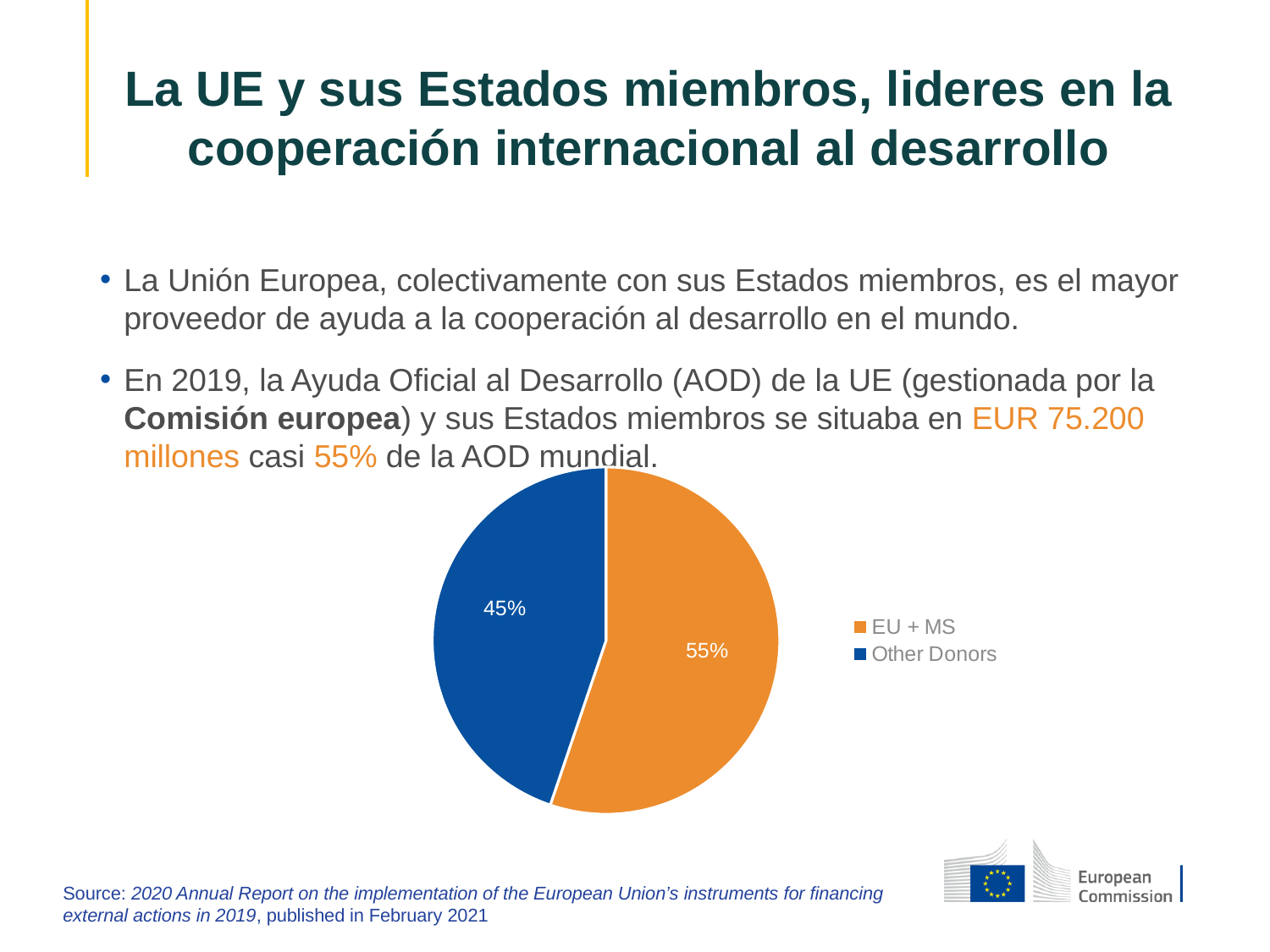
Which is larger, the EU + MS slice or the Other Donors slice? EU + MS Which slice of the pie is the largest? EU + MS How many entries does the legend list? 2 Which slice of the pie is the smallest? Other Donors What share of the pie does EU + MS represent? 55% What colour is the Other Donors slice? blue What kind of chart is shown on the slide? pie chart Is the share for EU + MS greater or less than 50%? greater What colour is the EU + MS slice? orange What is the difference in percentage points between the EU + MS slice and the Other Donors slice? 10 percentage points How many slices does the pie chart have? 2 What share of the pie does Other Donors represent? 45%